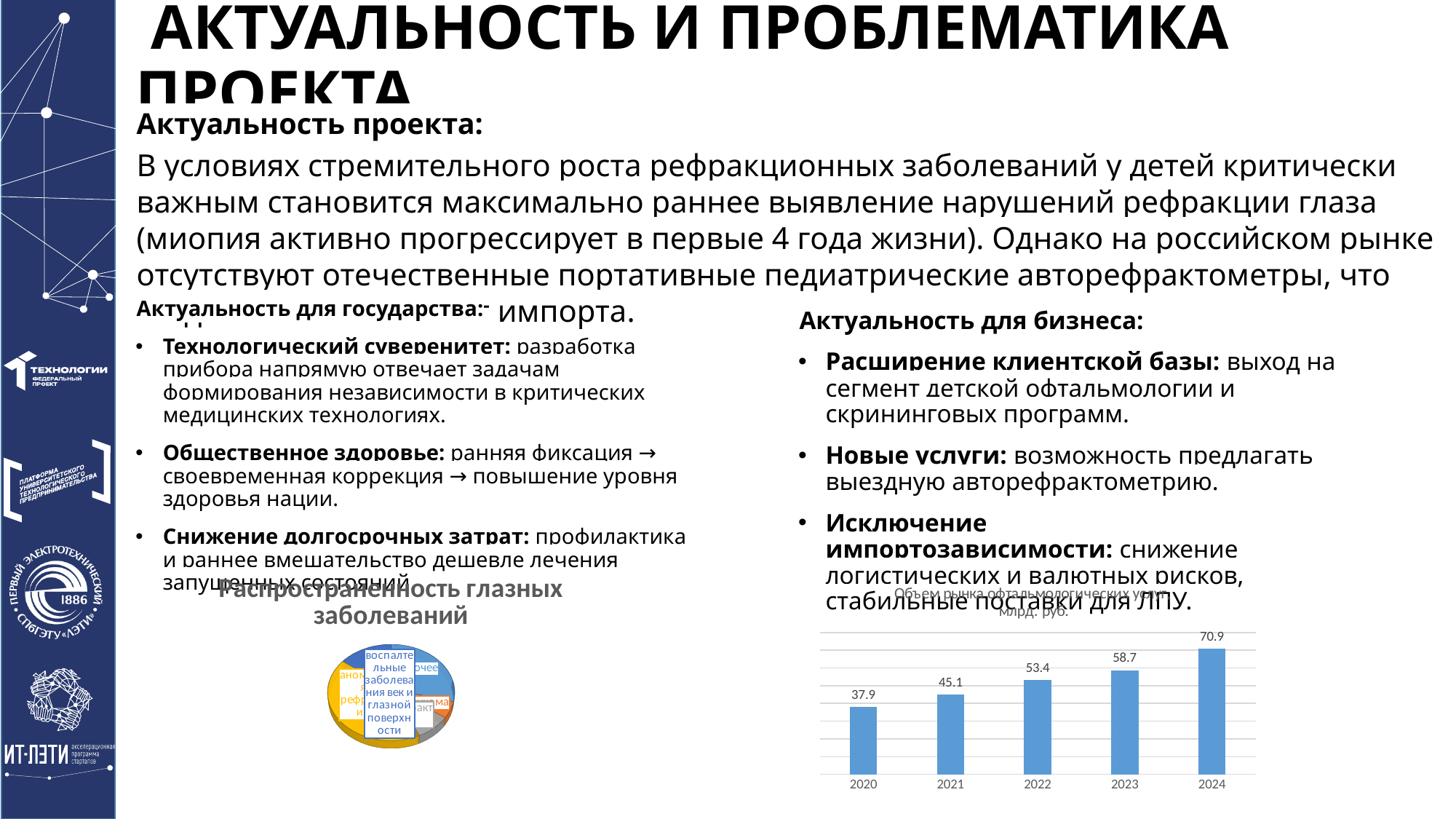
What kind of chart is shown on the right of the slide? bar chart On the bar chart on the right of the slide, which is larger, the value for 2021 or the value for 2023? 2023 On the bar chart on the right of the slide, which year has the lowest value? 2020 How many bars are shown on the bar chart on the right of the slide? 5 On the bar chart on the right of the slide, what is the difference between the values for 2024 and 2020? 33.0 On the bar chart on the right of the slide, what is the value for 2020? 37.9 On the bar chart on the right of the slide, what is the value for 2024? 70.9 On the bar chart on the right of the slide, what is the value for 2022? 53.4 On the bar chart on the right of the slide, which year has the highest value? 2024 What kind of chart is shown under the heading 'Распространенность глазных заболеваний'? pie chart On the bar chart on the right of the slide, what is the difference between the values for 2023 and 2022? 5.3 On the bar chart on the right of the slide, do the values rise or fall from 2020 to 2024? rise